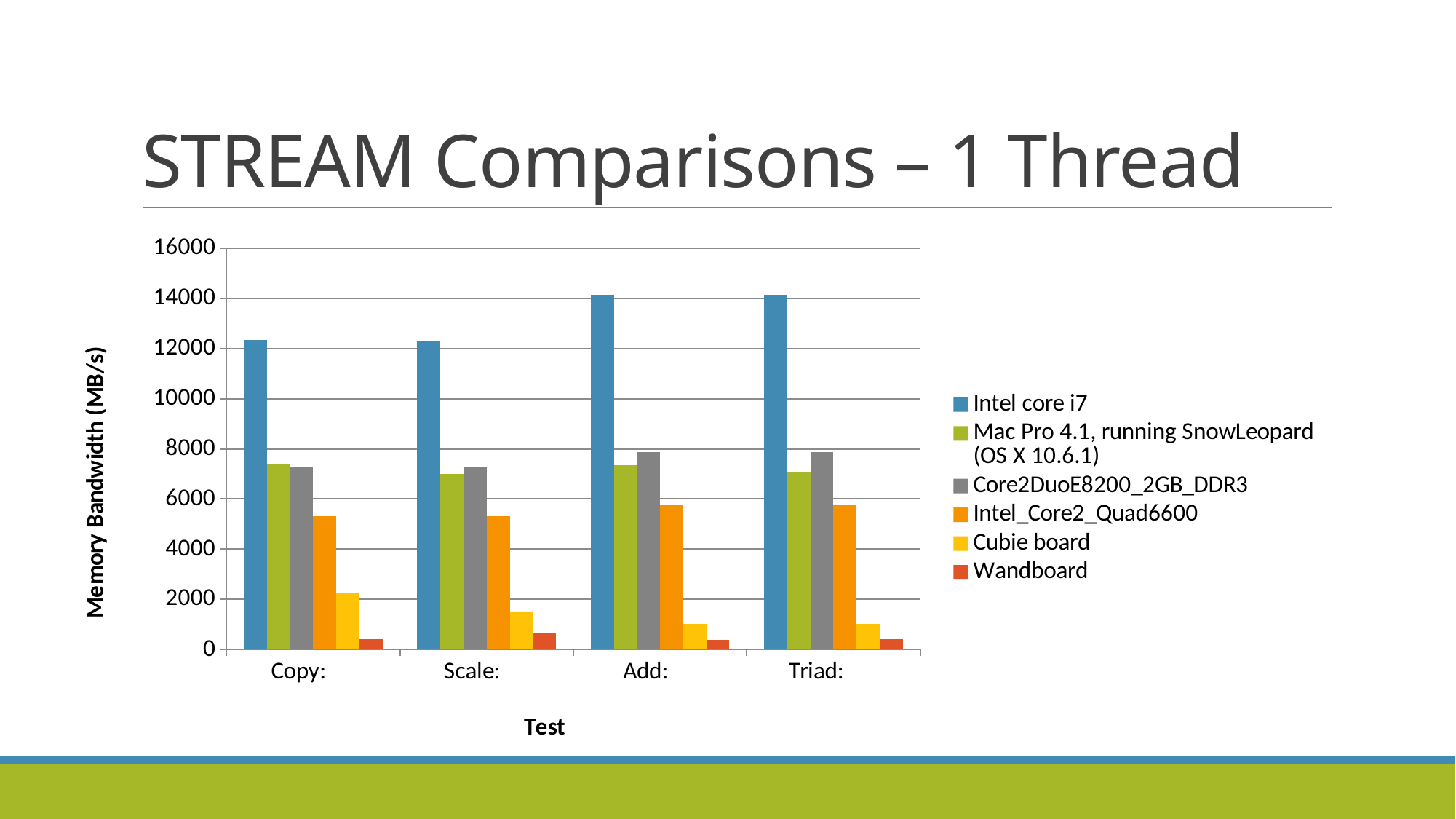
Is the value for Cubie board on the Scale test greater or less than 2000? less What is the title of the y axis? Memory Bandwidth (MB/s) How many series does the legend list? 6 Is the value for Wandboard on the Triad test greater or less than 1000? less Which series has the lowest memory bandwidth for the Copy test? Wandboard How many test categories are shown on the x axis? 4 For the Add test, which is larger: Core2DuoE8200_2GB_DDR3 or Mac Pro 4.1, running SnowLeopard (OS X 10.6.1)? Core2DuoE8200_2GB_DDR3 For the Cubie board, which is larger: the Copy value or the Scale value? Copy Is the value for Intel_Core2_Quad6600 on the Copy test greater or less than 4000? greater What kind of chart is shown on the slide? Bar chart Which series has the highest memory bandwidth for the Add test? Intel core i7